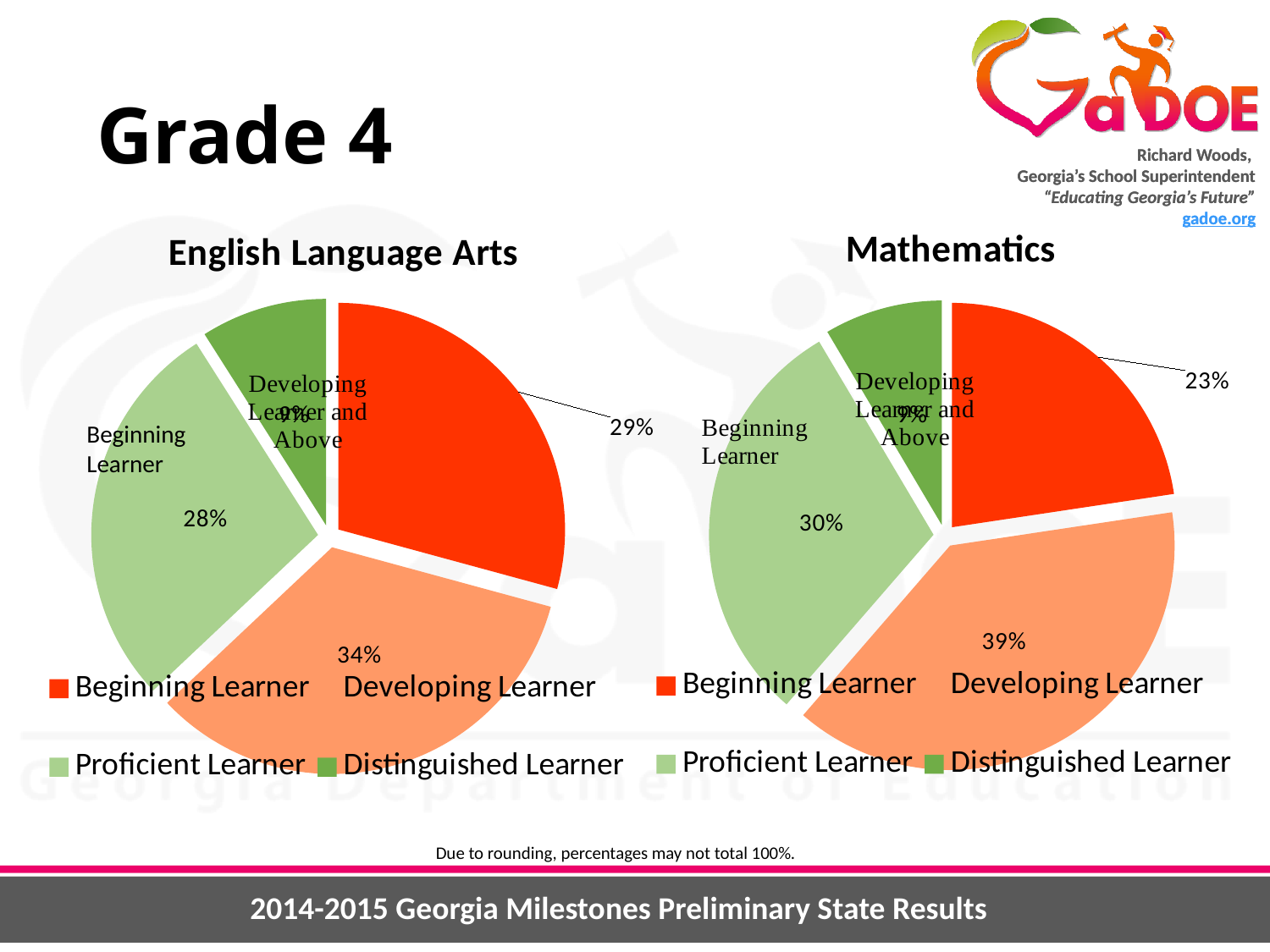
In the English Language Arts pie chart, what percentage of students are Developing Learners? 34% In the Mathematics pie chart, what percentage of students are Beginning Learners? 23% How many categories does the legend of the Mathematics chart list? 4 What type of chart is used for the English Language Arts data? Pie chart In the English Language Arts pie chart, which category has the largest slice? Developing Learner Which chart shows a larger percentage of Proficient Learners, English Language Arts or Mathematics? Mathematics In the Mathematics pie chart, which category has the smallest slice? Distinguished Learner In the Mathematics pie chart, what is the difference in percentage points between Developing Learners and Beginning Learners? 16 percentage points In the English Language Arts pie chart, what percentage of students are Beginning Learners? 29% In the Mathematics pie chart, what share of the pie is Proficient Learner? 30% In the English Language Arts pie chart, what percentage of students are Proficient Learners? 28% In the Mathematics pie chart, what percentage of students are Developing Learners? 39%